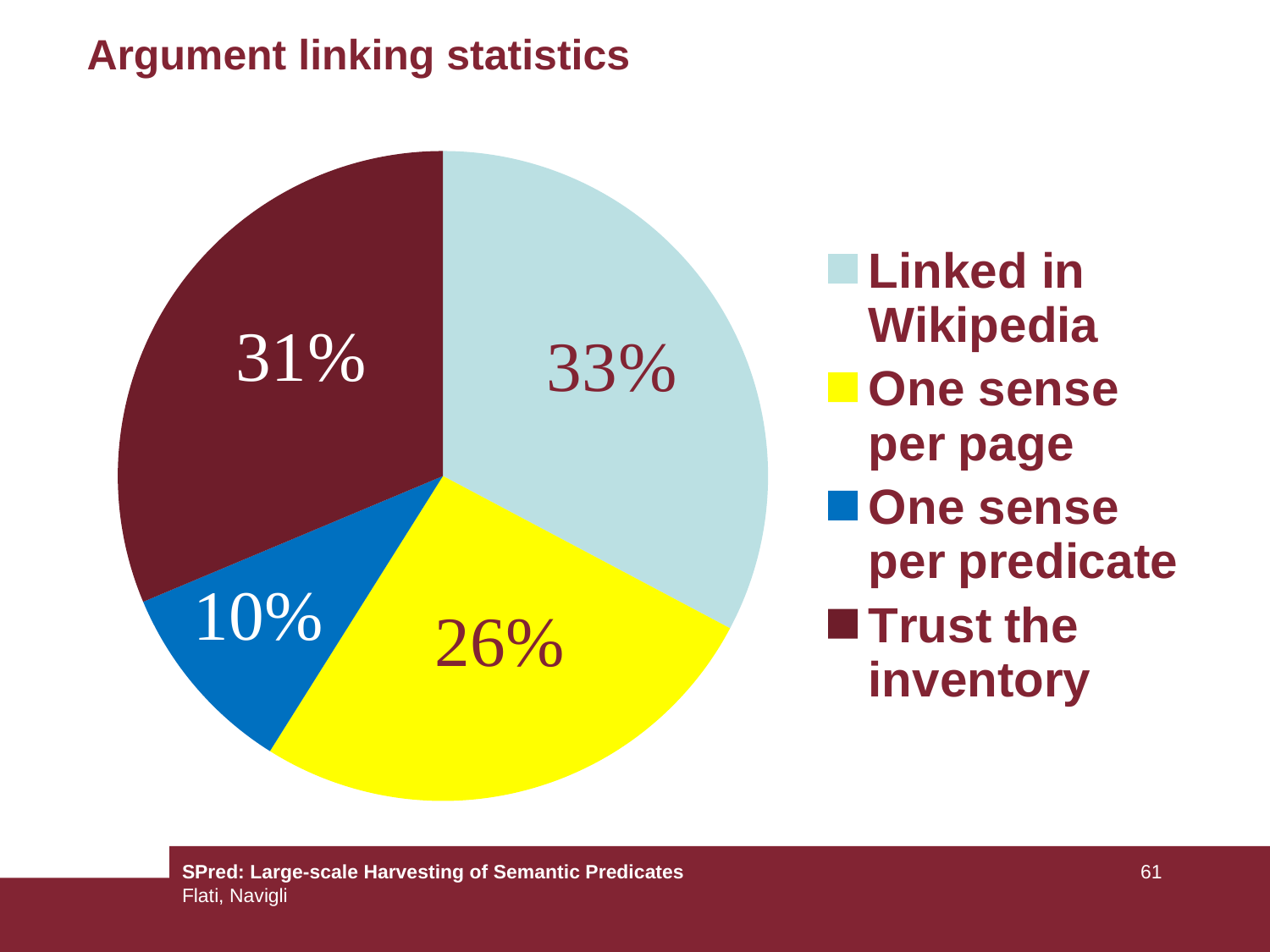
What share of the pie is labelled 'One sense per predicate'? 10% What kind of chart is shown on the slide? pie chart What share of the pie is labelled 'One sense per page'? 26% What colour is the slice for 'One sense per predicate'? blue Which category has the smallest slice of the pie? One sense per predicate What is the title of the slide containing the pie chart? Argument linking statistics How many slices does the pie chart have? 4 What is the difference in percentage points between 'Linked in Wikipedia' and 'One sense per predicate'? 23 Which is larger: 'One sense per page' or 'Trust the inventory'? Trust the inventory What share of the pie is labelled 'Trust the inventory'? 31% What share of the pie is labelled 'Linked in Wikipedia'? 33% Which category has the largest slice of the pie? Linked in Wikipedia